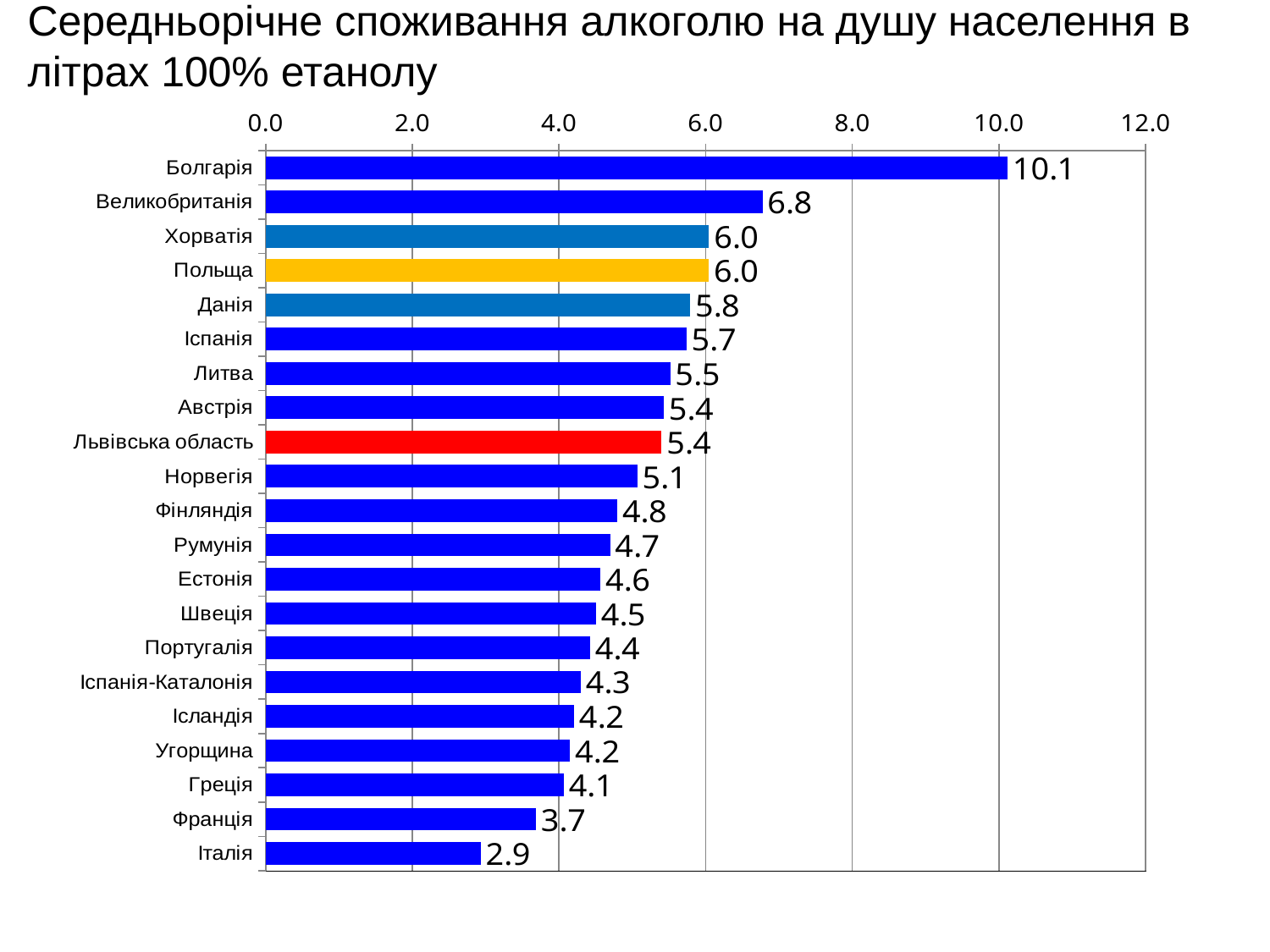
How many categories are shown in the chart? 21 What is the value for Львівська область? 5.4 What is the difference between the values for Данія and Італія? 2.9 What is the difference between the values for Болгарія and Великобританія? 3.3 Which bar is coloured red? Львівська область Which category has the lowest value? Італія What is the value for Болгарія? 10.1 What is the value for Франція? 3.7 Which category has the highest value? Болгарія Is the value for Великобританія greater or less than 6.0? greater What kind of chart is shown on the slide? bar chart Which is larger, the value for Норвегія or the value for Фінляндія? Норвегія